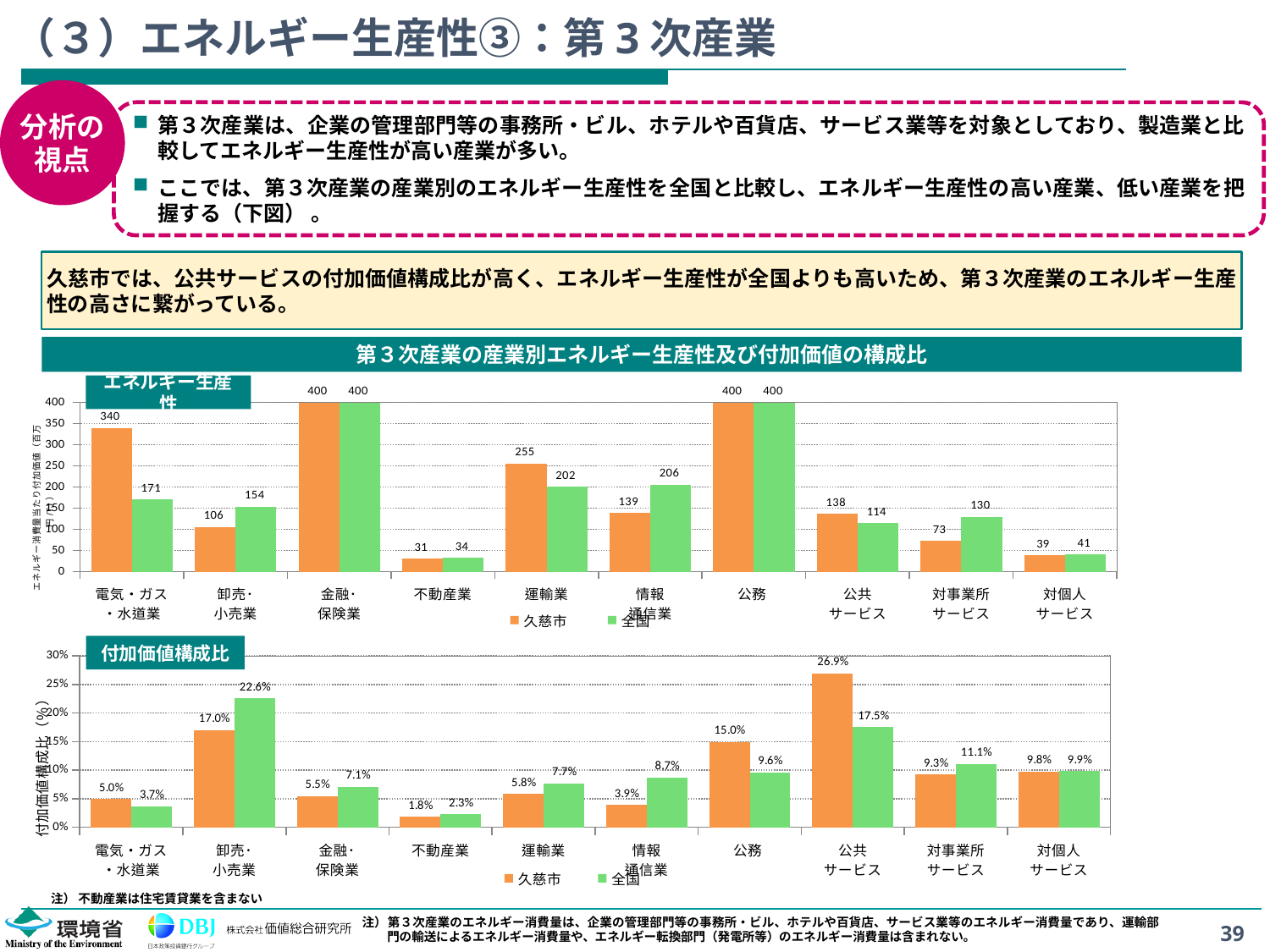
In the top chart (エネルギー生産性), what is the value for 全国 in 情報通信業? 206 How many series does the legend of the bottom chart (付加価値構成比) list? 2 In the top chart (エネルギー生産性), which category has the lowest value for 久慈市? 不動産業 In the top chart (エネルギー生産性), how many categories are shown on the x axis? 10 What type of chart is the top chart (エネルギー生産性)? Bar chart In the top chart (エネルギー生産性), which is larger in 対事業所サービス, 久慈市 or 全国? 全国 In the bottom chart (付加価値構成比), which is larger in 公務, 久慈市 or 全国? 久慈市 In the bottom chart (付加価値構成比), what is the difference between 全国 and 久慈市 in 情報通信業? 4.8% In the bottom chart (付加価値構成比), what is the value for 久慈市 in 公共サービス? 26.9% In the bottom chart (付加価値構成比), which category has the highest value for 全国? 卸売・小売業 In the top chart (エネルギー生産性), what is the difference between 久慈市 and 全国 in 運輸業? 53 In the top chart (エネルギー生産性), what is the value for 久慈市 in 電気・ガス・水道業? 340